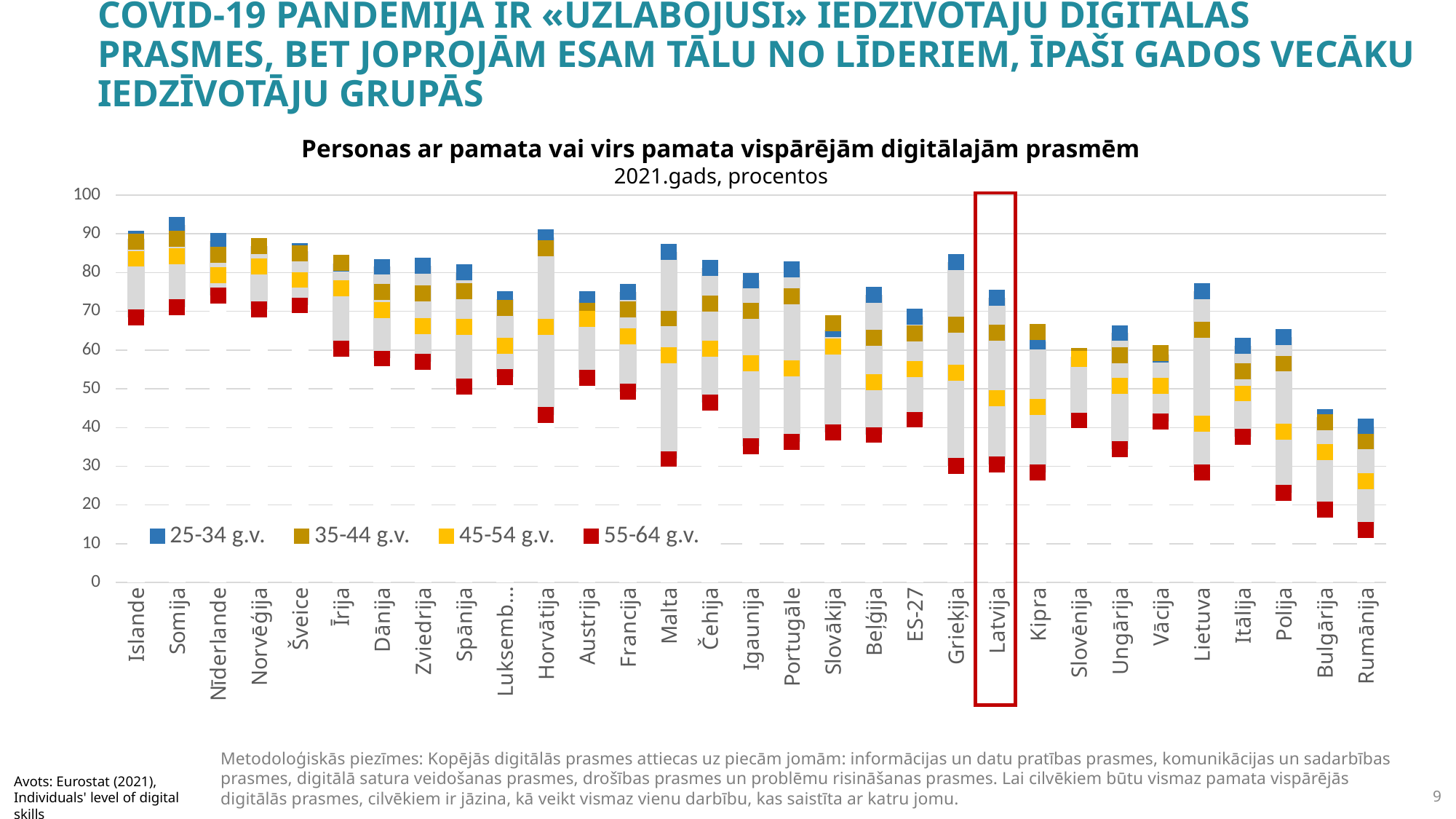
Which is larger: the 55-64 g.v. value for Islande or for Rumānija? Islande What is the title of the chart? Personas ar pamata vai virs pamata vispārējām digitālajām prasmēm Is the value for the 25-34 g.v. group in Bulgārija greater or less than 50? less How many series does the legend list? 4 How many countries/categories are shown on the x axis? 31 Is the value for the 55-64 g.v. group in Rumānija greater or less than 20? less Is the value for the 25-34 g.v. group in Islande greater or less than 80? greater Do the values for the 25-34 g.v. group generally rise or fall from left to right along the x axis? fall Which country is highlighted with a red box on the chart? Latvija Which country has the lowest value for the 55-64 g.v. group? Rumānija What kind of chart is shown on the slide? bar chart